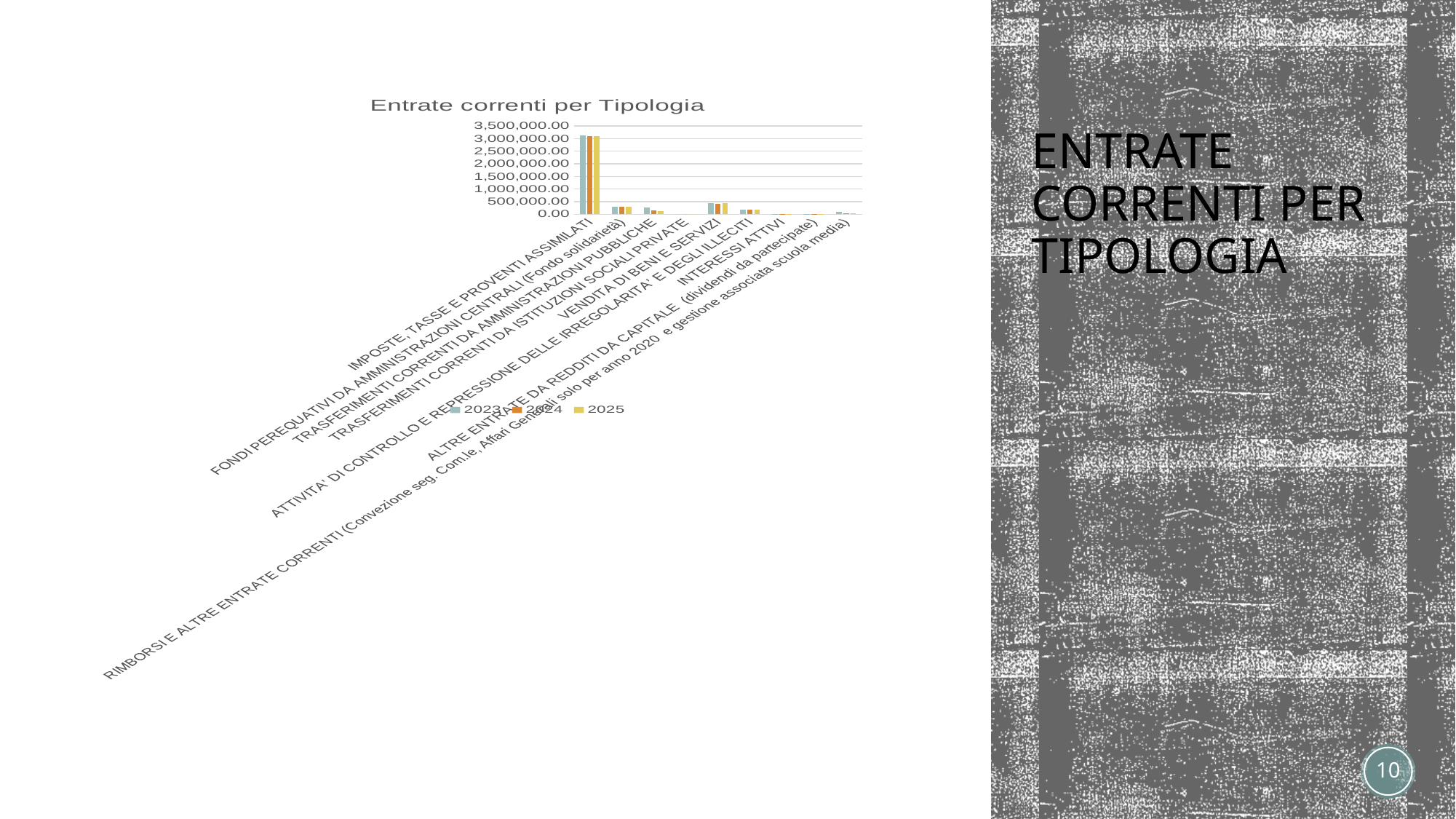
Which years are listed in the chart legend? 2023, 2024, 2025 What is the title of the chart? Entrate correnti per Tipologia Which category has the highest values in the chart? IMPOSTE, TASSE E PROVENTI ASSIMILATI Is the 2025 value for FONDI PEREQUATIVI DA AMMINISTRAZIONI CENTRALI (Fondo solidarietà) greater or less than 500,000.00? less Which is larger in 2024: IMPOSTE, TASSE E PROVENTI ASSIMILATI or VENDITA DI BENI E SERVIZI? IMPOSTE, TASSE E PROVENTI ASSIMILATI Is the 2024 value for VENDITA DI BENI E SERVIZI greater or less than 1,000,000.00? less What kind of chart is shown on the slide? bar chart Which is larger in 2023: VENDITA DI BENI E SERVIZI or INTERESSI ATTIVI? VENDITA DI BENI E SERVIZI Is the 2023 value for IMPOSTE, TASSE E PROVENTI ASSIMILATI greater or less than 2,500,000.00? greater How many series does the legend list? 3 What is the highest value shown on the y axis of the chart? 3,500,000.00 How many categories are shown on the x axis of the chart? 9